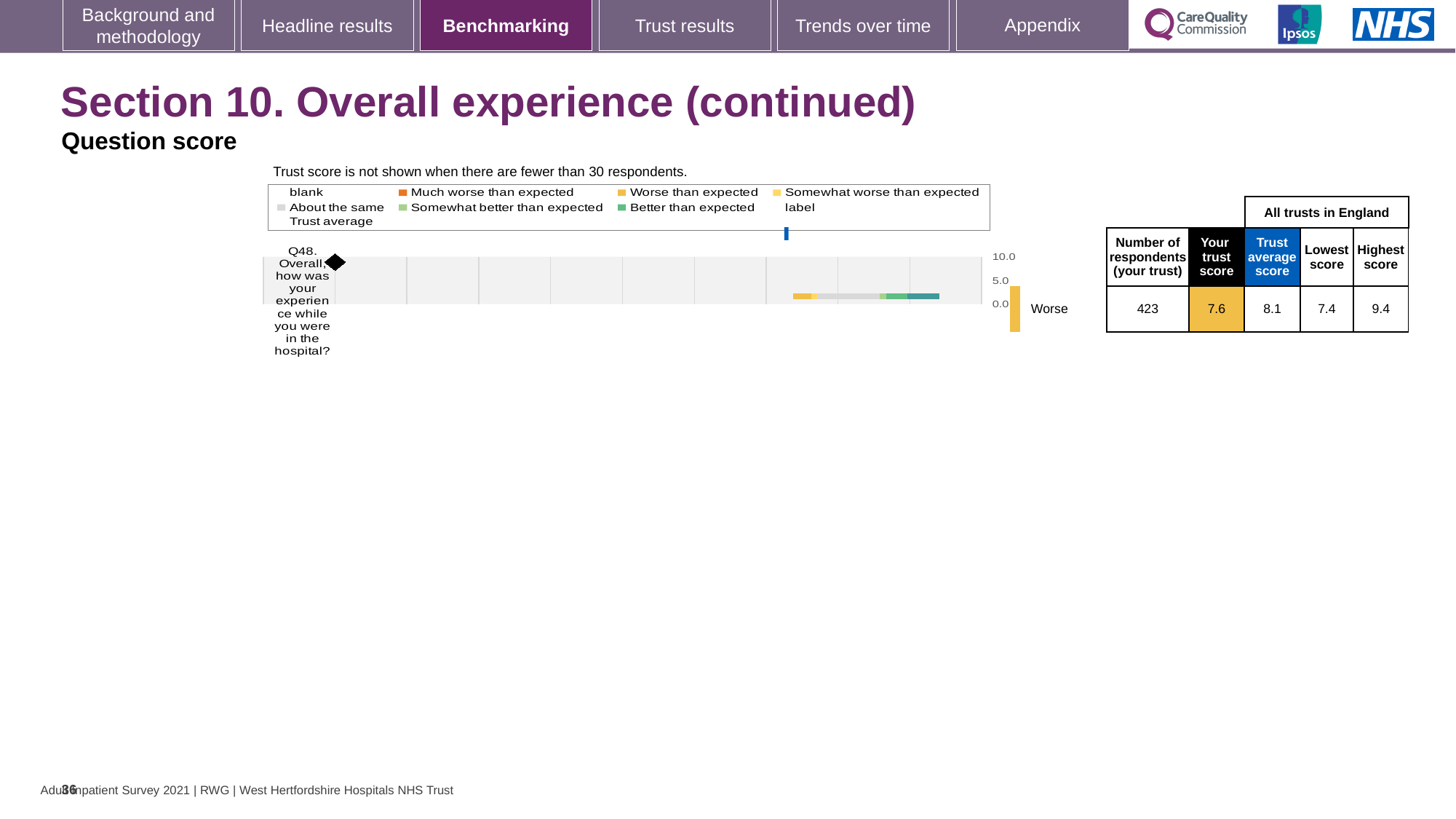
Is your trust score for Q48 greater or less than 5.0 on the chart's axis? greater By how much does the trust average score exceed your trust score for Q48? 0.5 What is the lowest score across all trusts in England for Q48? 7.4 What is the trust average score for Q48 shown in the table beside the chart? 8.1 How many respondents from your trust answered Q48? 423 What is the highest score across all trusts in England for Q48? 9.4 What is the 'Your trust score' for Q48 shown in the table beside the chart? 7.6 How many questions are plotted in the benchmarking chart? 1 What benchmark category label is shown next to the small bar on the right of the chart for Q48? Worse What kind of chart is used to show the Q48 benchmarking result? bar chart What is the difference between the highest score and the lowest score for Q48? 2.0 Is your trust score for Q48 higher or lower than the trust average score? lower